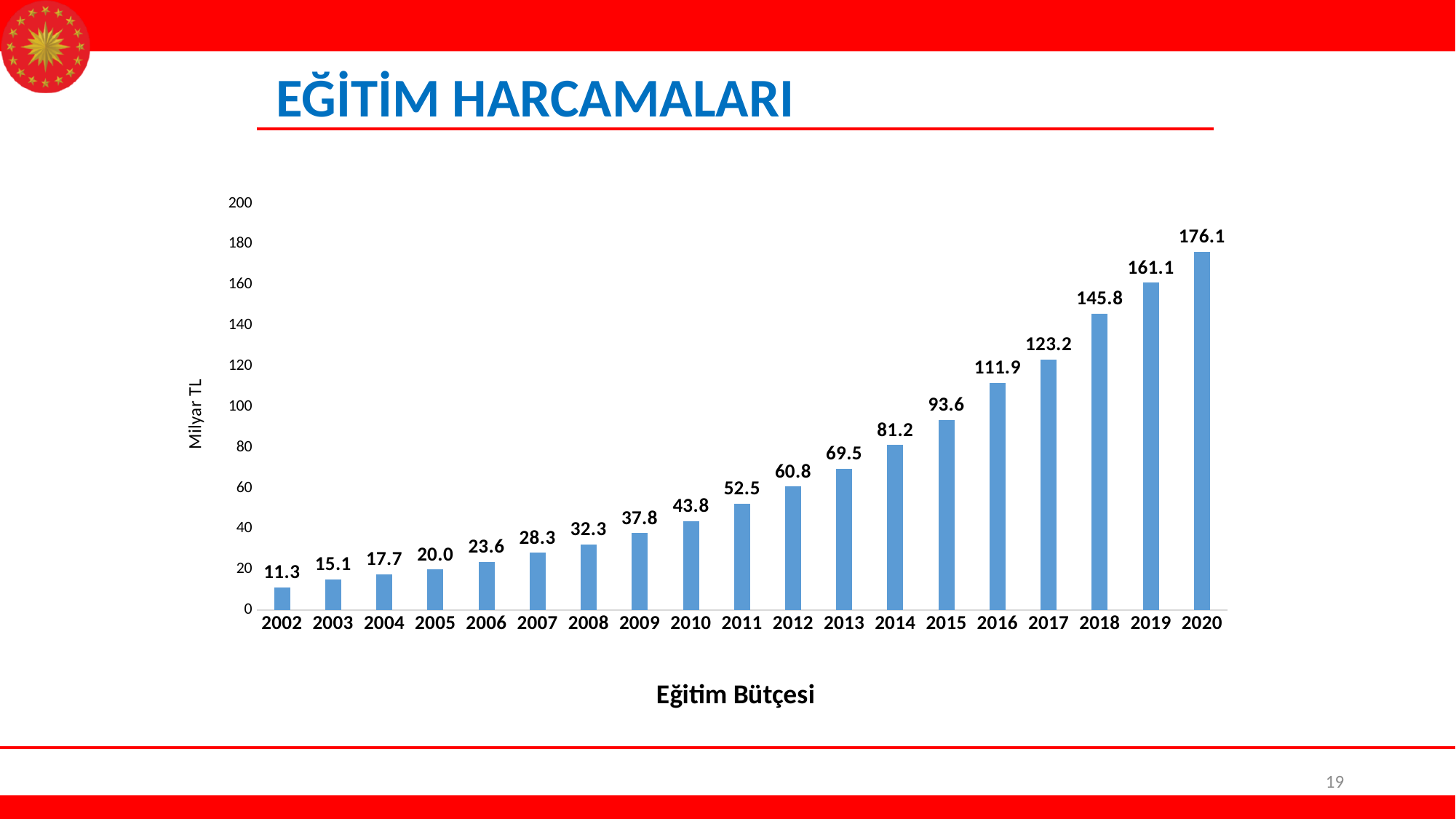
What is the difference between the values for 2020 and 2019? 15.0 What kind of chart is this? bar chart How many years are shown on the x axis? 19 What is the value for 2002? 11.3 What is the value for 2010? 43.8 Do the values rise or fall from 2002 to 2020? rise Which year has the highest value? 2020 Which is larger, the value for 2012 or the value for 2013? 2013 Is the value for 2016 greater or less than 100? greater Which year has the lowest value? 2002 What is the difference between the values for 2015 and 2014? 12.4 What is the value for 2017? 123.2